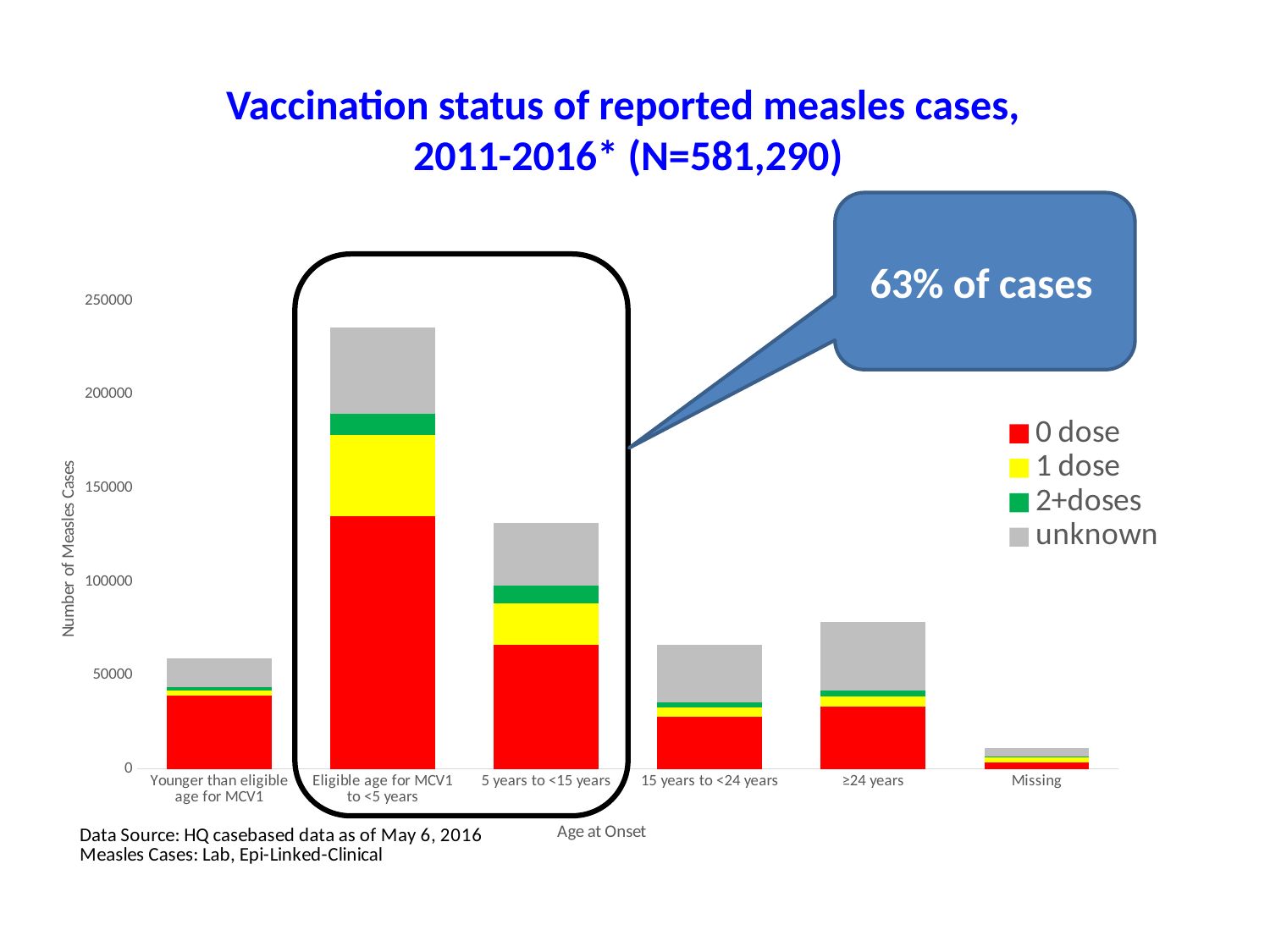
Is the total number of cases for 'Missing' greater or less than 50000? less Is the total number of cases for '5 years to <15 years' greater or less than 100000? greater Which age category has the highest total number of measles cases? Eligible age for MCV1 to <5 years What kind of chart is shown on the slide? Stacked bar chart Which age category has the lowest total number of measles cases? Missing Is the total number of cases for 'Eligible age for MCV1 to <5 years' greater or less than 200000? greater Which colour represents the 'unknown' series in the legend? Grey How many series does the legend list? 4 Which has more total measles cases: '5 years to <15 years' or '≥24 years'? 5 years to <15 years How many age categories are shown on the x axis? 6 What is the title of the chart? Vaccination status of reported measles cases, 2011-2016* (N=581,290)